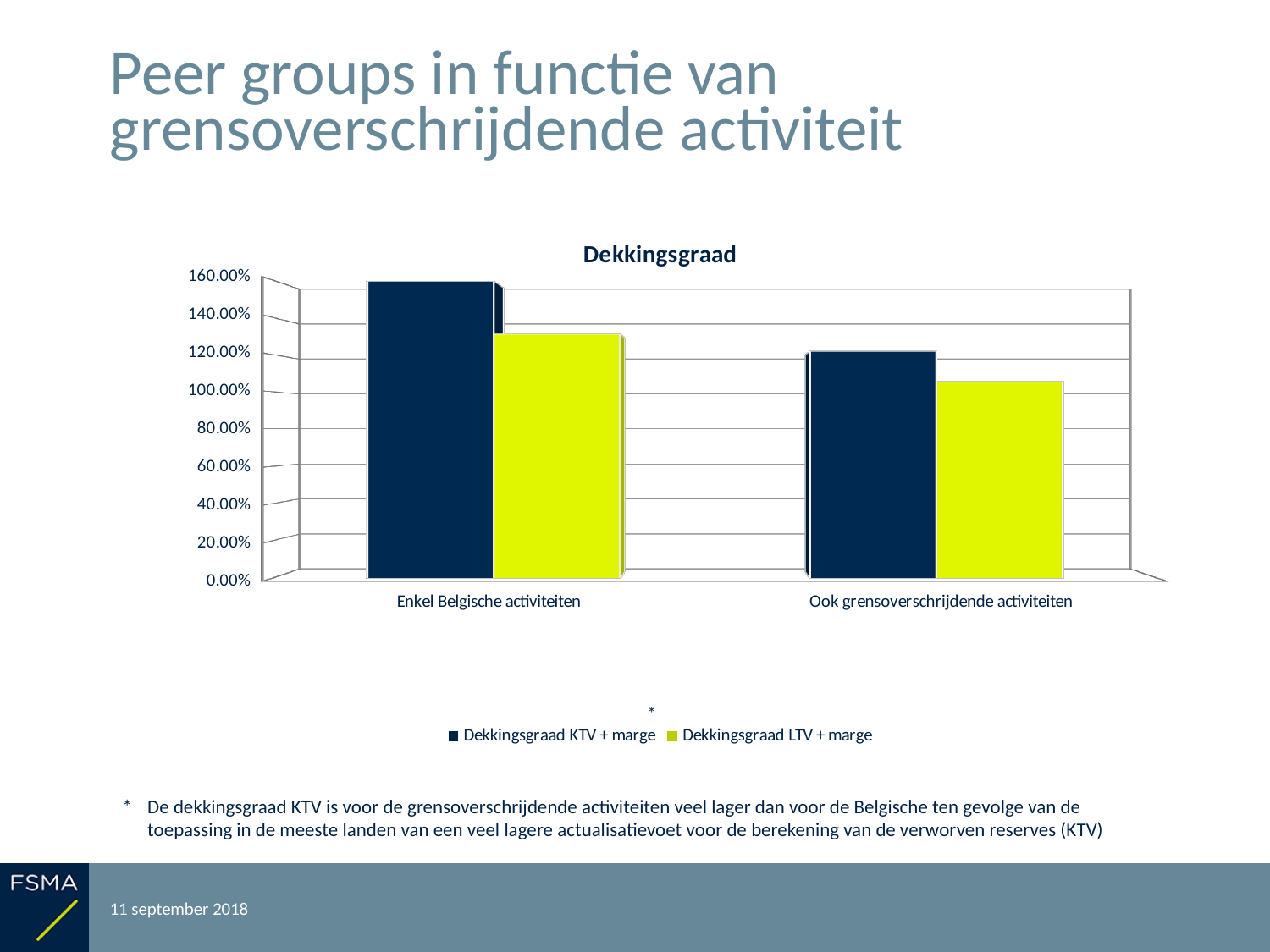
What is the title of the chart? Dekkingsgraad Which category has the lowest Dekkingsgraad LTV + marge? Ook grensoverschrijdende activiteiten Is the value of Dekkingsgraad KTV + marge for Enkel Belgische activiteiten greater or less than 140.00%? greater How many categories are shown on the x axis? 2 Is the value of Dekkingsgraad KTV + marge for Ook grensoverschrijdende activiteiten greater or less than 100.00%? greater How many series does the legend list? 2 What type of chart is shown on the slide? bar chart Which series is shown in dark navy blue? Dekkingsgraad KTV + marge Is the value of Dekkingsgraad LTV + marge for Ook grensoverschrijdende activiteiten greater or less than 120.00%? less For Enkel Belgische activiteiten, which is larger: Dekkingsgraad KTV + marge or Dekkingsgraad LTV + marge? Dekkingsgraad KTV + marge Which category has the highest Dekkingsgraad KTV + marge? Enkel Belgische activiteiten